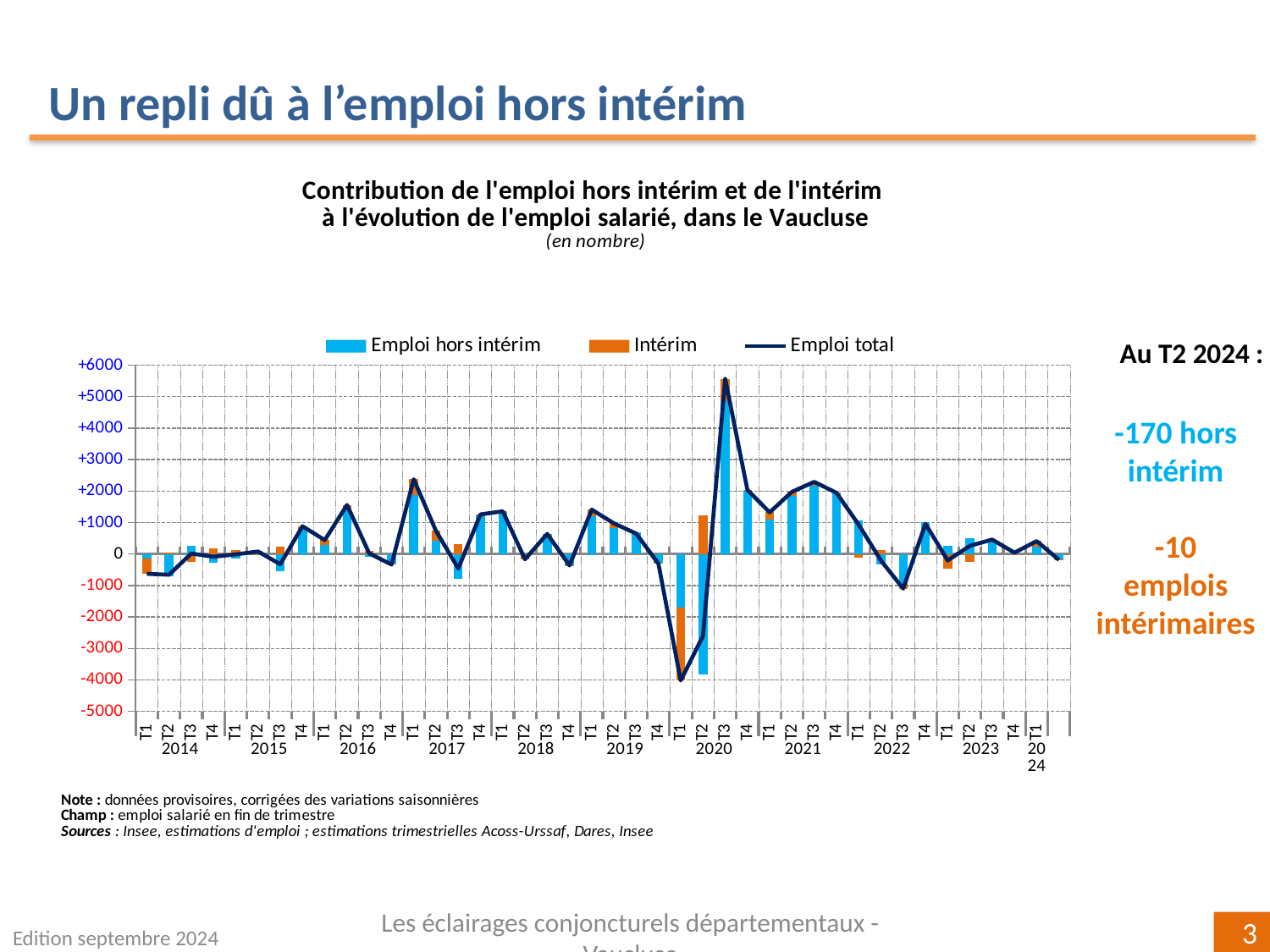
Is the Emploi total value for T1 2020 greater or less than -3000? less What kind of chart is shown on the slide? A combined bar and line chart Which series is drawn as a line rather than bars? Emploi total In which quarter does the Emploi hors intérim bar reach its lowest value? T2 2020 In which quarter does the Emploi hors intérim bar reach its highest value? T3 2020 How many series does the chart legend list? 3 What are the three series named in the chart legend? Emploi hors intérim, Intérim, Emploi total Is the Emploi hors intérim value for T1 2017 greater or less than +1000? greater Which is larger, the Intérim value for T1 2020 or for T2 2020? T2 2020 Is the Emploi hors intérim value for T1 2020 greater or less than -3000? greater What is the highest tick value shown on the vertical axis? +6000